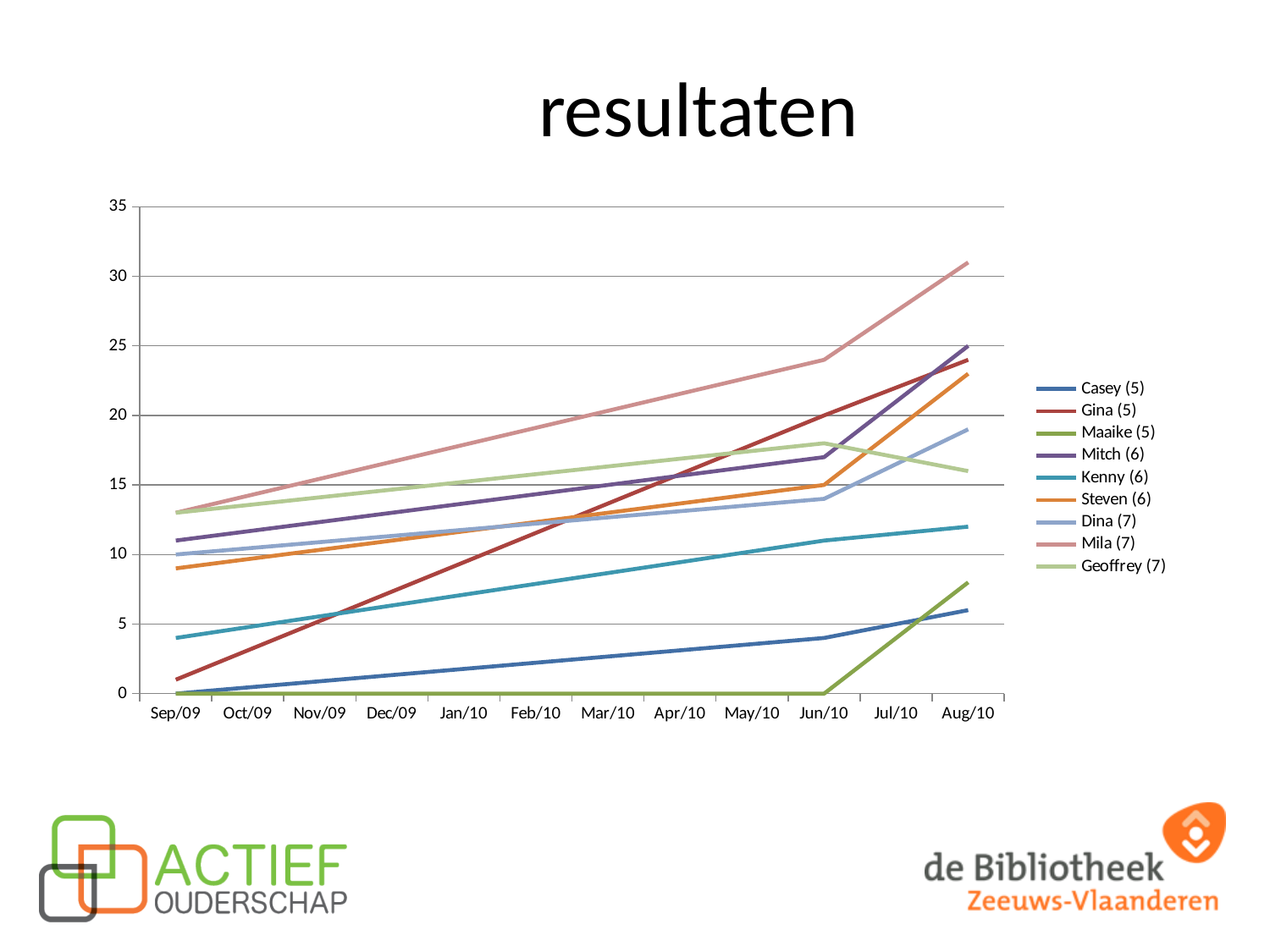
Is the value for Kenny (6) at Aug/10 greater or less than 15? less Does the line for Geoffrey (7) rise or fall between Jun/10 and Aug/10? fall At Jun/10, which is larger: Mila (7) or Mitch (6)? Mila (7) What is the value for Dina (7) at Sep/09? 10 Which series has the highest value at Aug/10? Mila (7) What kind of chart is shown on the slide? line chart Which series has the lowest value at Aug/10? Casey (5) Is the value for Mila (7) at Aug/10 greater or less than 25? greater Is the value for Gina (5) at Sep/09 greater or less than 5? less What is the value for Maaike (5) at Sep/09? 0 How many series does the legend list? 9 How many months are shown along the x axis? 12